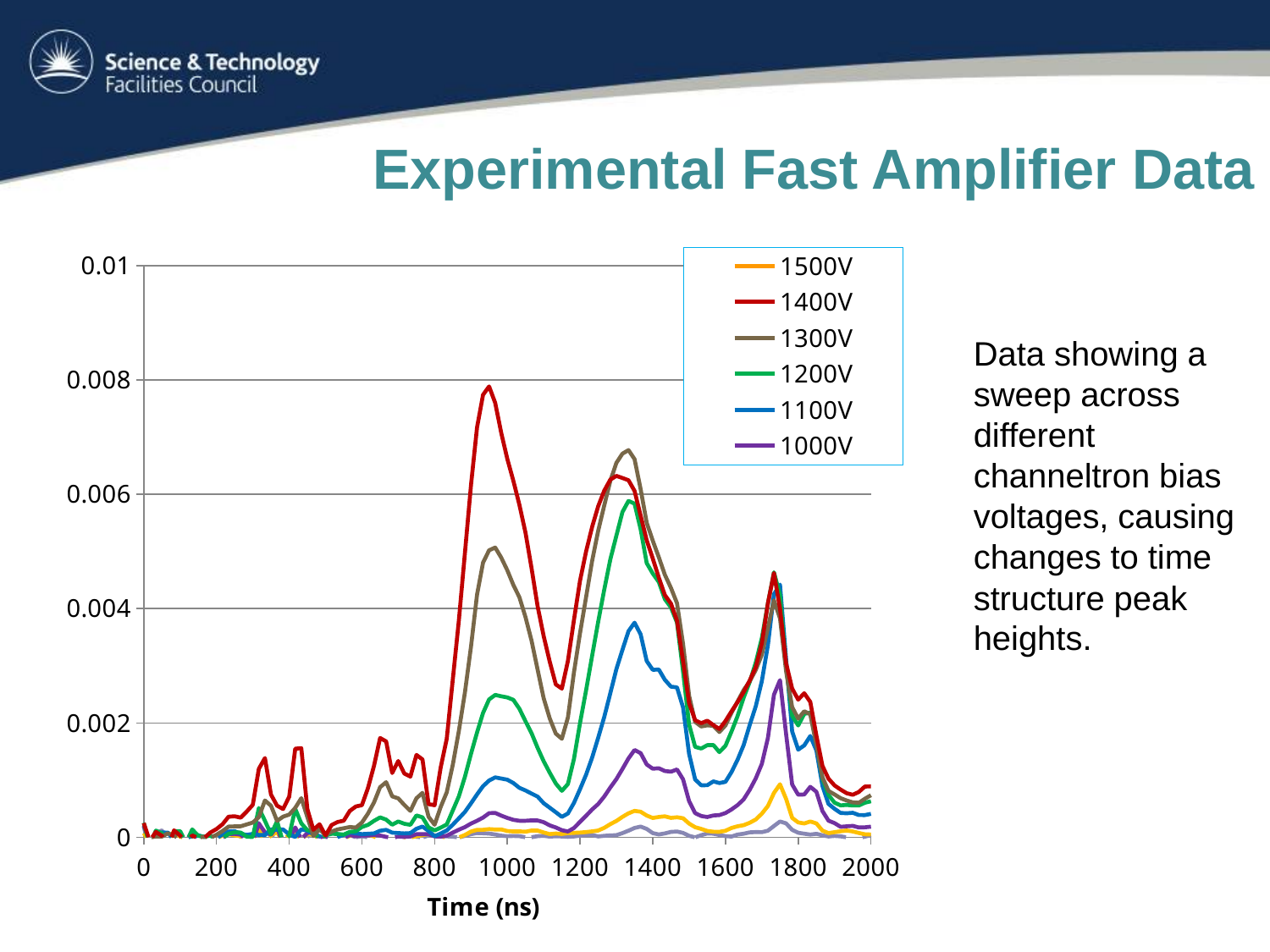
Which series reaches the highest peak on the chart? 1400V What kind of chart is shown on the slide? line chart How many series does the legend list? 6 Is the highest peak of the 1200V series greater or less than 0.004? greater Is the highest peak of the 1300V series greater or less than 0.006? greater Is the highest peak of the 1400V series greater or less than 0.006? greater What is the title of the x axis? Time (ns) Between 800 ns and 950 ns, does the 1400V line rise or fall? rise What colour is the 1400V series line? red